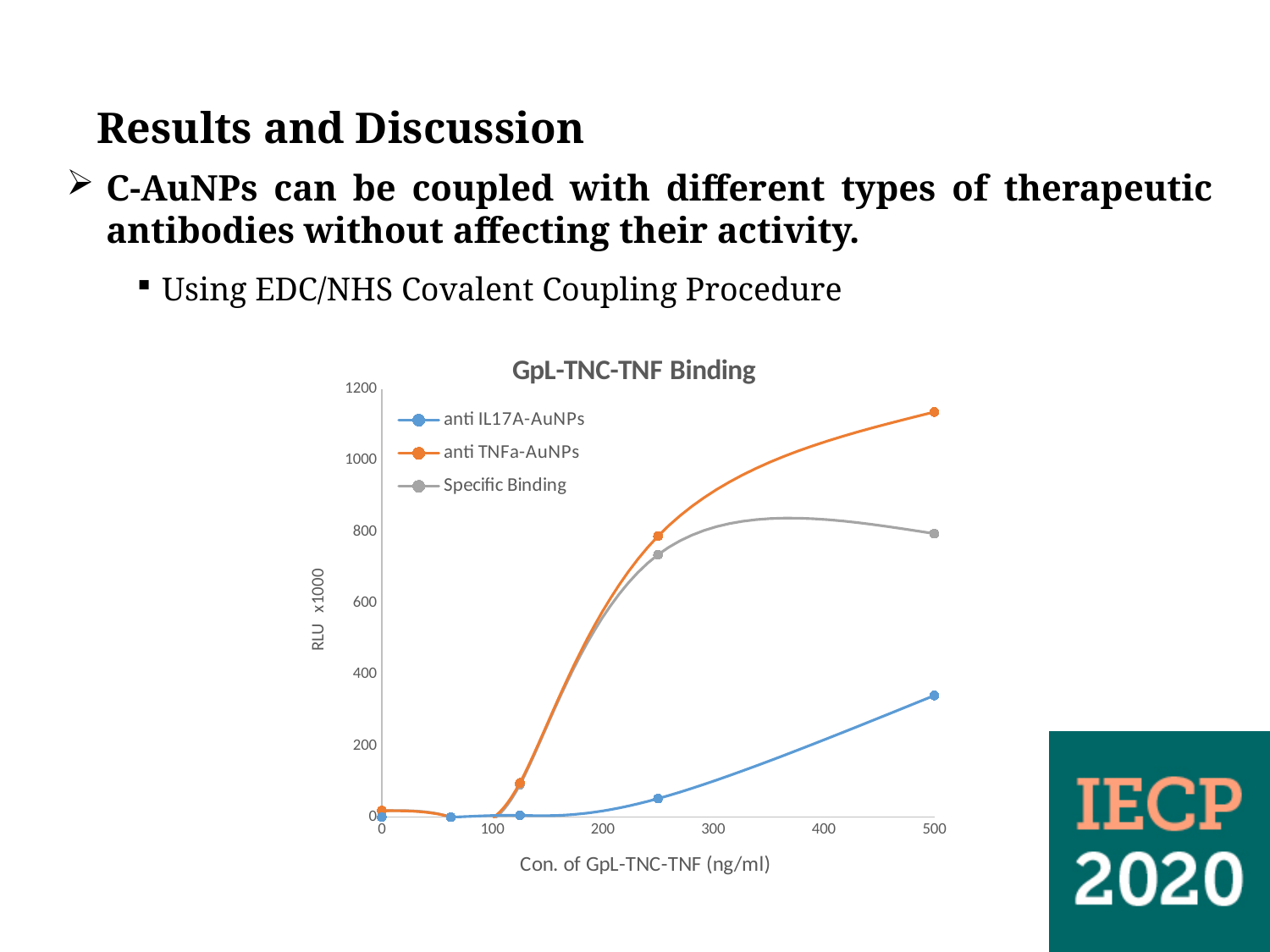
What kind of chart is shown on the slide? line chart What is the label of the x axis of the chart? Con. of GpL-TNC-TNF (ng/ml) Is the value for anti IL17A-AuNPs at 500 ng/ml greater or less than 400? less Which series has the highest value at a concentration of 500 ng/ml? anti TNFa-AuNPs Is the value for Specific Binding at 500 ng/ml greater or less than 600? greater Is the value for anti TNFa-AuNPs at 500 ng/ml greater or less than 1000? greater What is the title of the chart? GpL-TNC-TNF Binding How many series does the chart legend list? 3 At 500 ng/ml, which is larger: the value for anti TNFa-AuNPs or the value for anti IL17A-AuNPs? anti TNFa-AuNPs Does the anti TNFa-AuNPs series rise or fall as the concentration increases from 100 to 500 ng/ml? rise Which series has the lowest value at a concentration of 500 ng/ml? anti IL17A-AuNPs